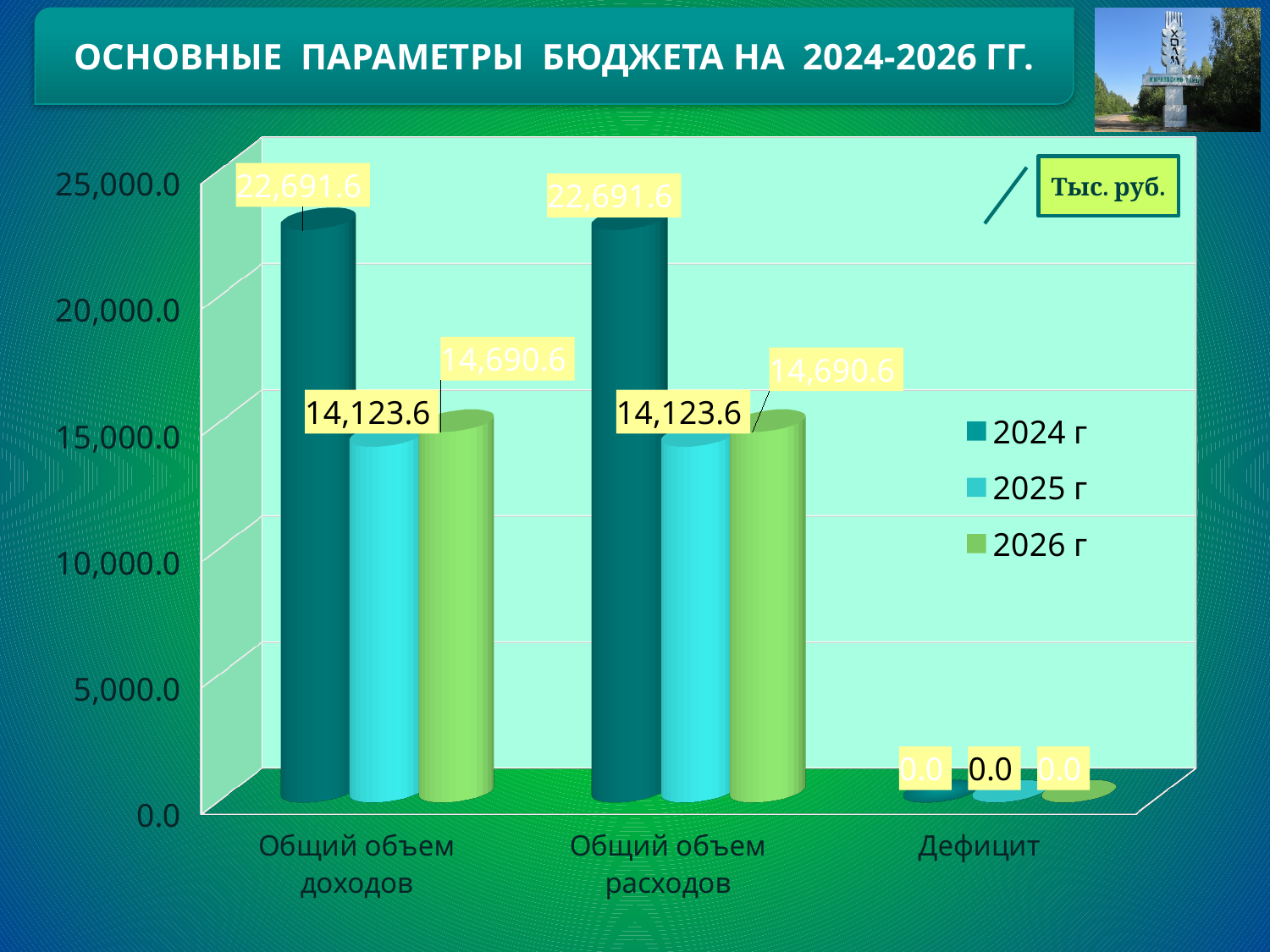
What is the value for 2024 г in the Общий объем доходов category? 22,691.6 What is the value for 2025 г in the Общий объем расходов category? 14,123.6 How many categories are shown on the x axis? 3 Which year has the lowest value in the Общий объем доходов category? 2025 г What is the value for 2026 г in the Общий объем доходов category? 14,690.6 How many series does the legend list? 3 What unit is indicated in the box at the top right of the chart? Тыс. руб. What is the difference between the 2024 г and 2025 г values in the Общий объем доходов category? 8,568.0 What kind of chart is shown on the slide? Bar chart Which is larger in the Общий объем расходов category: the 2026 г value or the 2025 г value? 2026 г Which year has the highest value in the Общий объем расходов category? 2024 г What is the value for 2025 г in the Дефицит category? 0.0